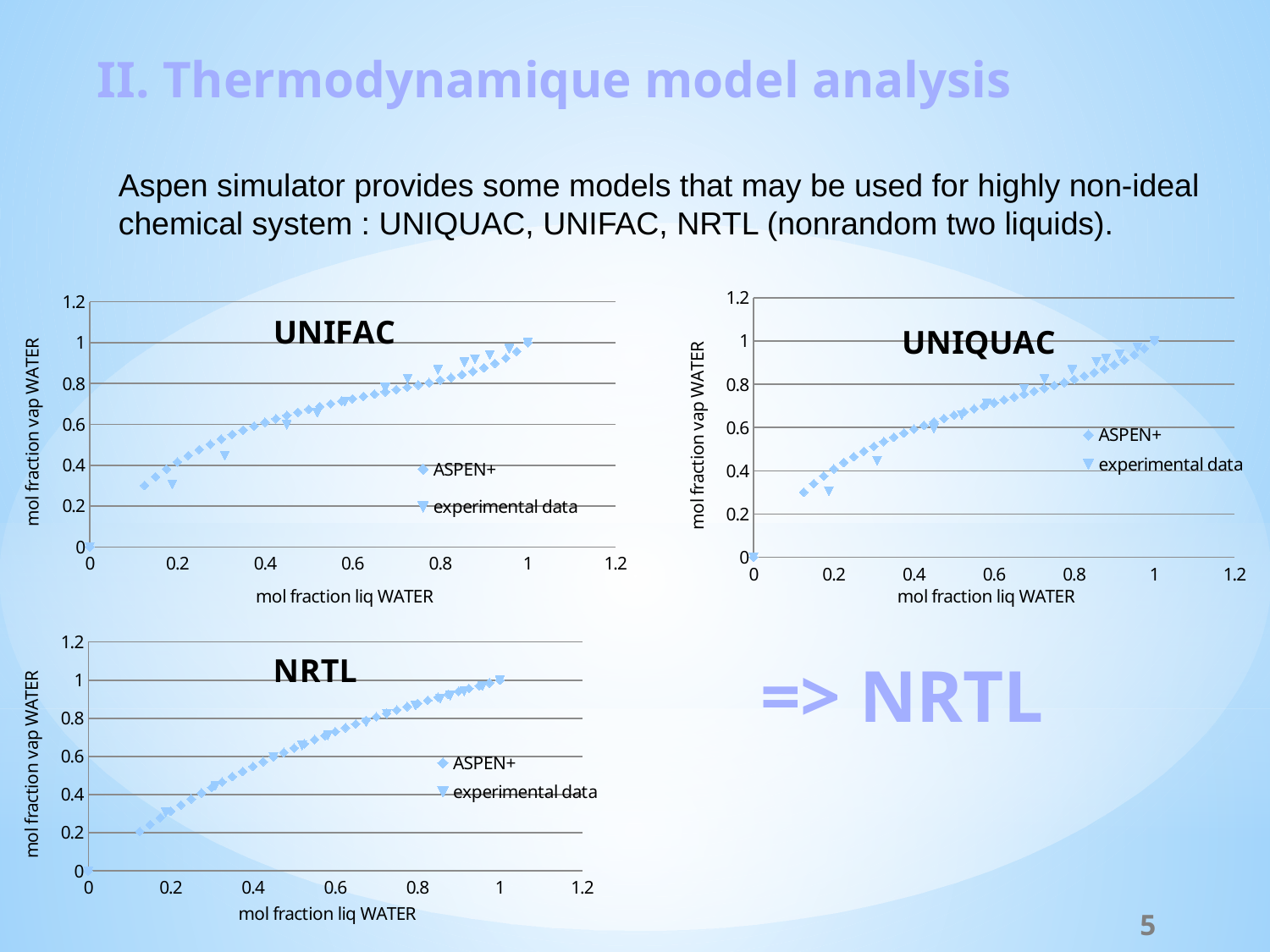
How many series does the legend of the UNIQUAC chart list? 2 What are the two series named in the legend of the NRTL chart? ASPEN+ and experimental data In the UNIQUAC chart, is the ASPEN+ value at mol fraction liq WATER 0.4 greater or less than 0.8? less In the UNIQUAC chart, do the values rise or fall along the x axis? rise In the NRTL chart, is the ASPEN+ value at mol fraction liq WATER 0.8 greater or less than 0.6? greater What kind of chart is the UNIFAC chart? scatter chart In the NRTL chart, do the values rise or fall as mol fraction liq WATER increases? rise In the UNIFAC chart, is the ASPEN+ value at mol fraction liq WATER 0.2 greater or less than 0.6? less What is the x-axis title of the UNIFAC chart? mol fraction liq WATER What kind of chart is the NRTL chart? scatter chart How many charts are shown on the slide? 3